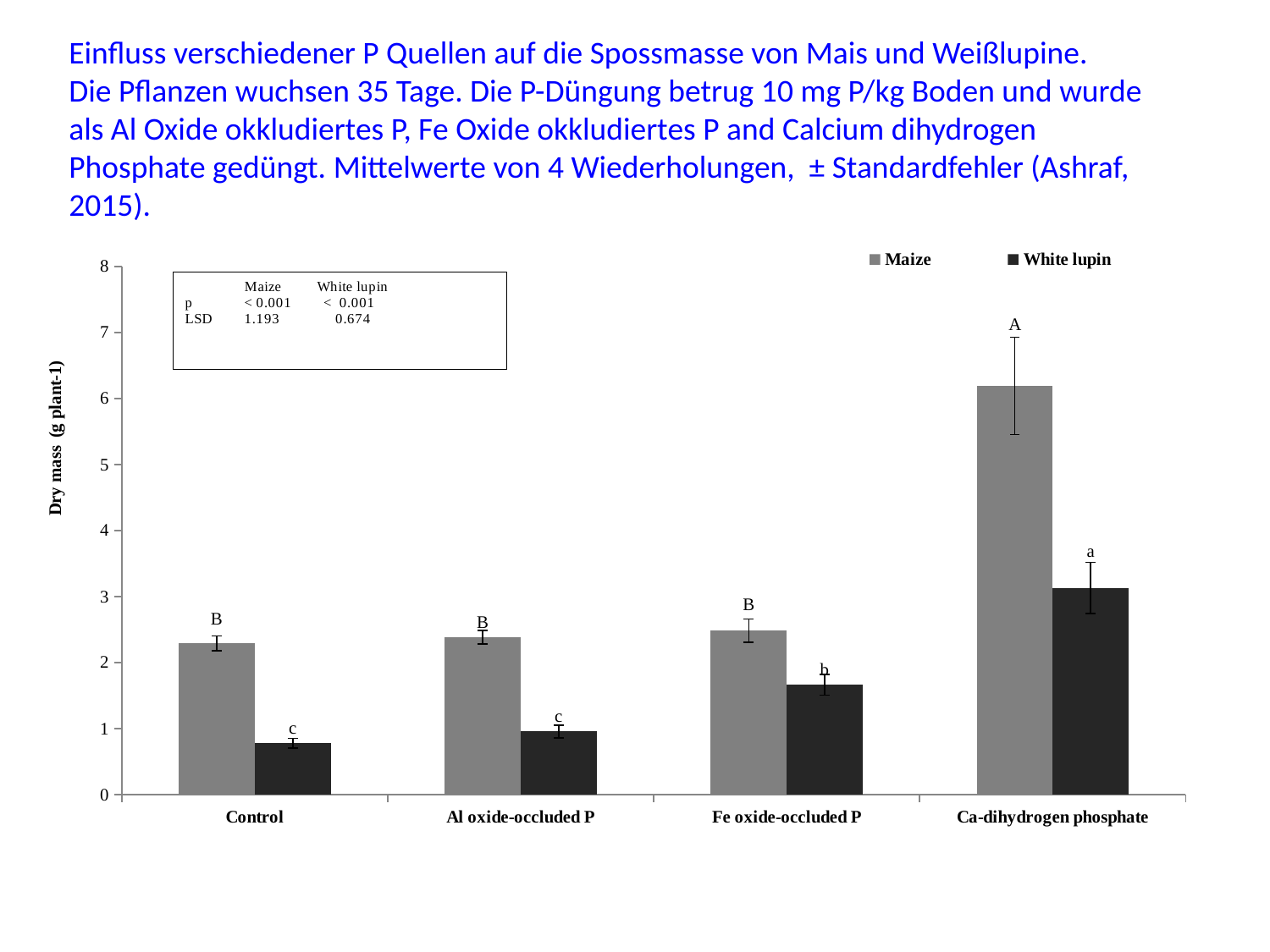
How many series does the legend list? 2 For Fe oxide-occluded P, which series has the larger dry mass, Maize or White lupin? Maize Which category has the highest Maize dry mass? Ca-dihydrogen phosphate Is the White lupin value for Ca-dihydrogen phosphate greater or less than 4? less What is the label of the y axis? Dry mass (g plant-1) Which category has the highest White lupin dry mass? Ca-dihydrogen phosphate Is the White lupin value for Control greater or less than 1? less Is the Maize value for Ca-dihydrogen phosphate greater or less than 5? greater How many categories are shown on the x axis? 4 What type of chart is shown on the slide? bar chart Which category has the lowest White lupin dry mass? Control